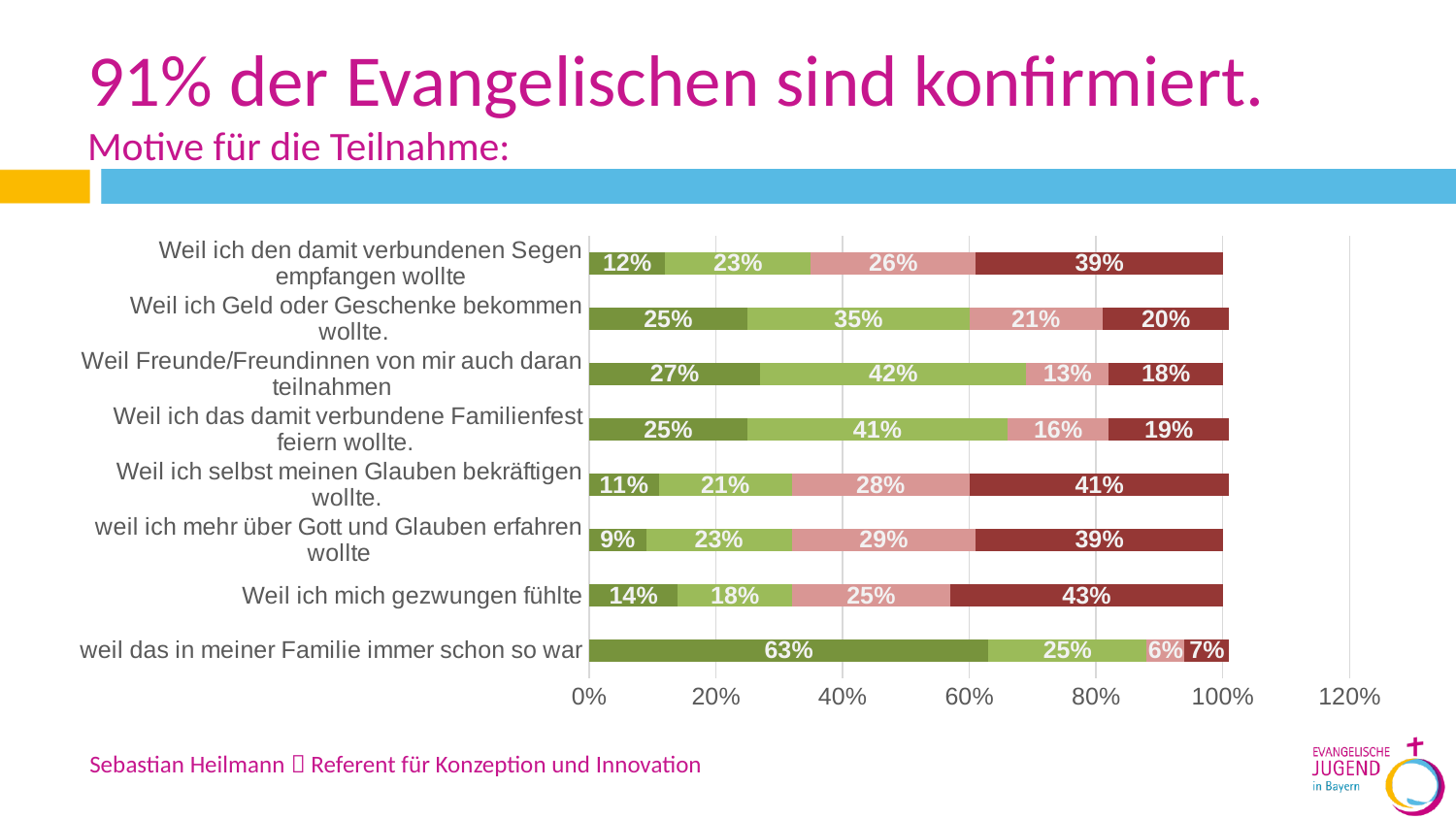
What is the value of the dark green (first) segment for "weil das in meiner Familie immer schon so war"? 63% How many categories (motives) are plotted in the chart? 8 What is the value of the dark red (last) segment for "Weil ich mich gezwungen fühlte"? 43% How many coloured segments make up each stacked bar? 4 Which has the larger dark red (last) segment: "Weil ich mich gezwungen fühlte" or "Weil ich selbst meinen Glauben bekräftigen wollte."? Weil ich mich gezwungen fühlte Which category has the largest dark green (first) segment? weil das in meiner Familie immer schon so war What is the value of the light green (second) segment for "Weil Freunde/Freundinnen von mir auch daran teilnahmen"? 42% Is the dark green (first) segment for "Weil Freunde/Freundinnen von mir auch daran teilnahmen" greater or less than 20%? greater What kind of chart is shown on the slide? bar chart What is the difference between the dark green segment (63%) and the light green segment (25%) for "weil das in meiner Familie immer schon so war"? 38 percentage points What is the total of the stacked bar for "Weil ich den damit verbundenen Segen empfangen wollte"? 100% Which category has the smallest dark green (first) segment? weil ich mehr über Gott und Glauben erfahren wollte